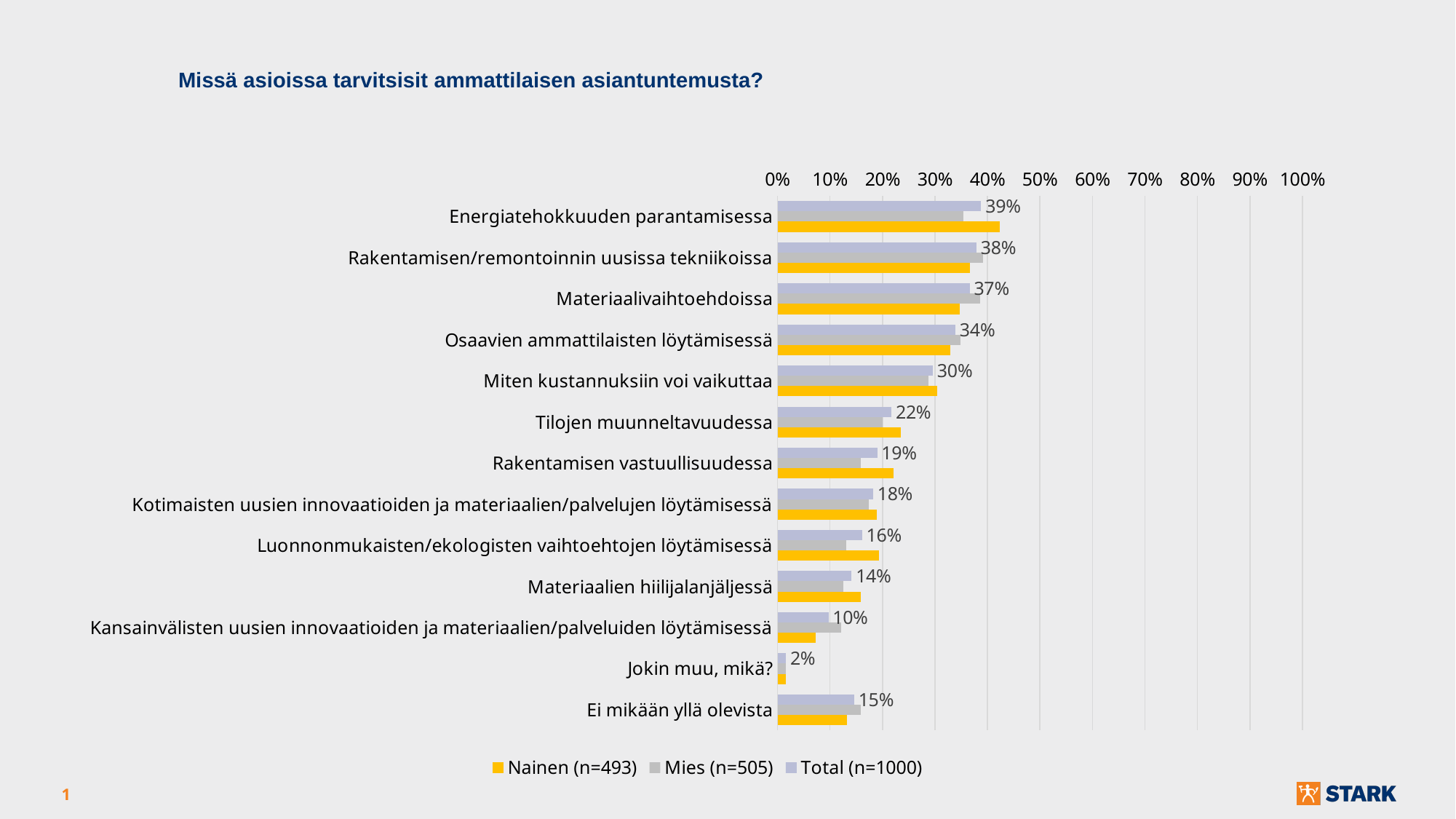
How many categories are shown on the chart? 13 Which has the larger Total value: Rakentamisen vastuullisuudessa or Ei mikään yllä olevista? Rakentamisen vastuullisuudessa What is the Total (n=1000) value for Jokin muu, mikä? 2% Which category has the highest Total (n=1000) value? Energiatehokkuuden parantamisessa Is the Nainen (n=493) value for Energiatehokkuuden parantamisessa greater or less than 40%? greater What is the Total (n=1000) value for Energiatehokkuuden parantamisessa? 39% What is the Total (n=1000) value for Tilojen muunneltavuudessa? 22% Is the Nainen (n=493) value for Kansainvälisten uusien innovaatioiden ja materiaalien/palveluiden löytämisessä greater or less than 10%? less How many series does the legend list? 3 Which category has the lowest Total (n=1000) value? Jokin muu, mikä? What is the difference between the Total values for Miten kustannuksiin voi vaikuttaa and Tilojen muunneltavuudessa? 8 percentage points What type of chart is shown on the slide? Bar chart